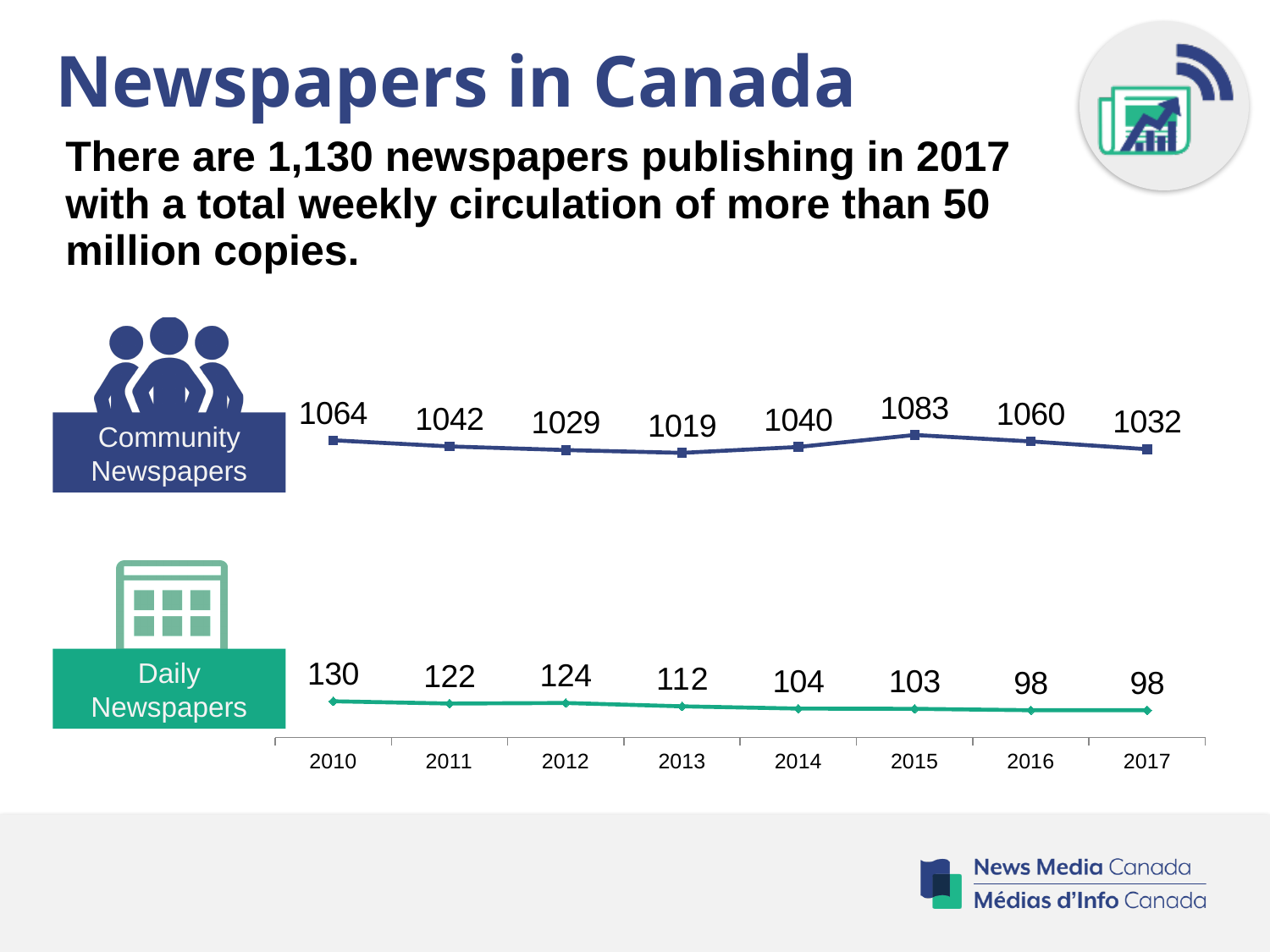
Which year had more Daily Newspapers, 2011 or 2012? 2012 How many series are plotted on the chart? 2 What is the difference between the number of Daily Newspapers in 2010 and in 2017? 32 In which year was the number of Daily Newspapers highest? 2010 In which year was the number of Community Newspapers lowest? 2013 Does the number of Daily Newspapers generally rise or fall from 2010 to 2017? fall How many Daily Newspapers were there in 2013? 112 What is the difference between the number of Community Newspapers in 2015 and in 2016? 23 How many years are plotted on the x axis? 8 In which year was the number of Community Newspapers highest? 2015 How many Community Newspapers were there in 2015? 1083 What kind of chart is shown on the slide? line chart